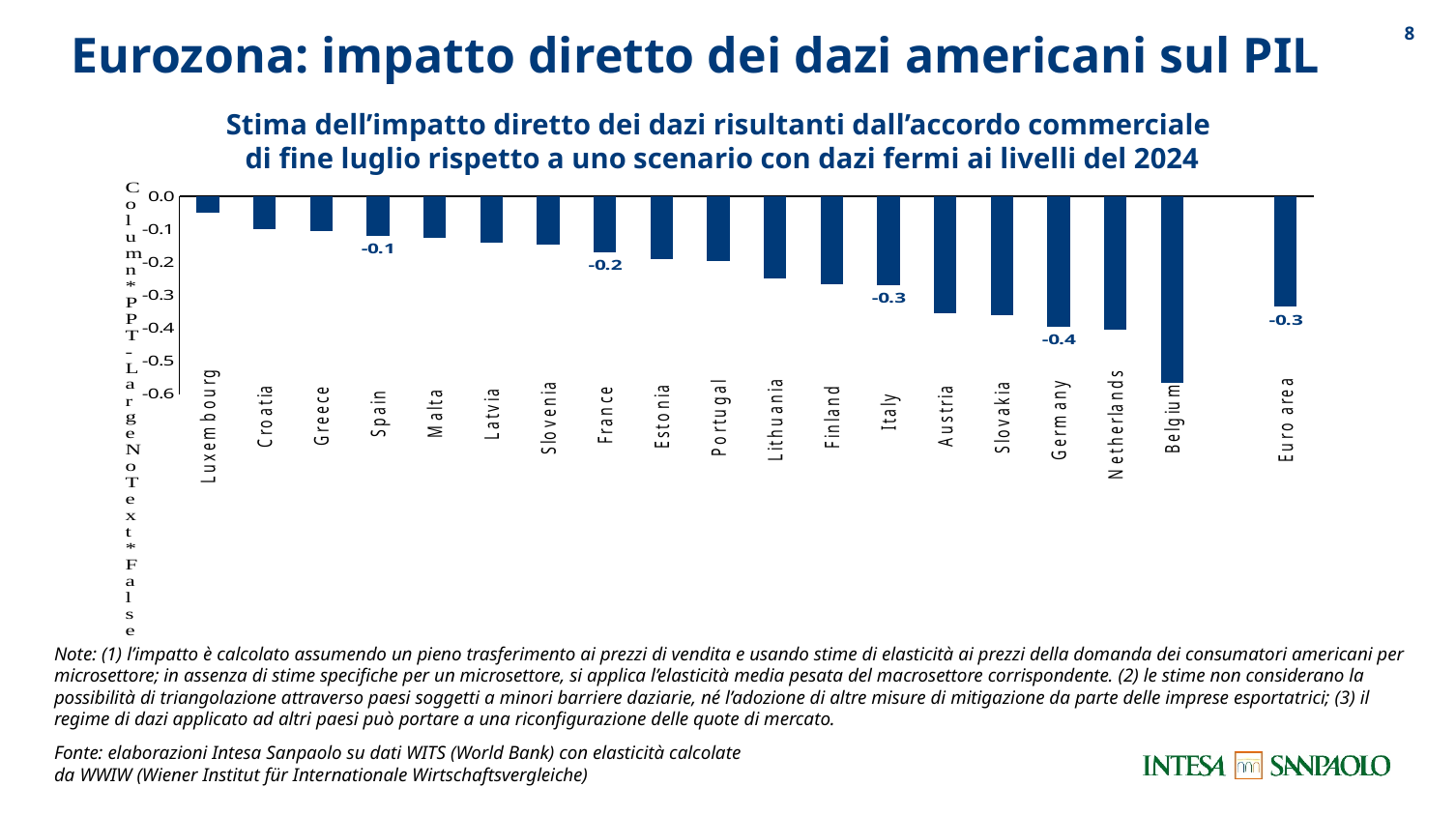
What type of chart is shown on the slide? Bar chart Is the value for Belgium greater or less than -0.5? less What is the value shown for Italy? -0.3 Do the values generally rise or fall moving from Luxembourg to Belgium along the x axis? fall Which country has the value closest to zero (the highest bar)? Luxembourg Which shows a larger negative impact, Germany or Italy? Germany What is the value shown for France? -0.2 What is the value shown for the Euro area? -0.3 What is the difference between the values for Germany and Spain? 0.3 Which country has the most negative value (the lowest bar)? Belgium What is the value shown for Germany? -0.4 How many categories are shown on the x axis? 19